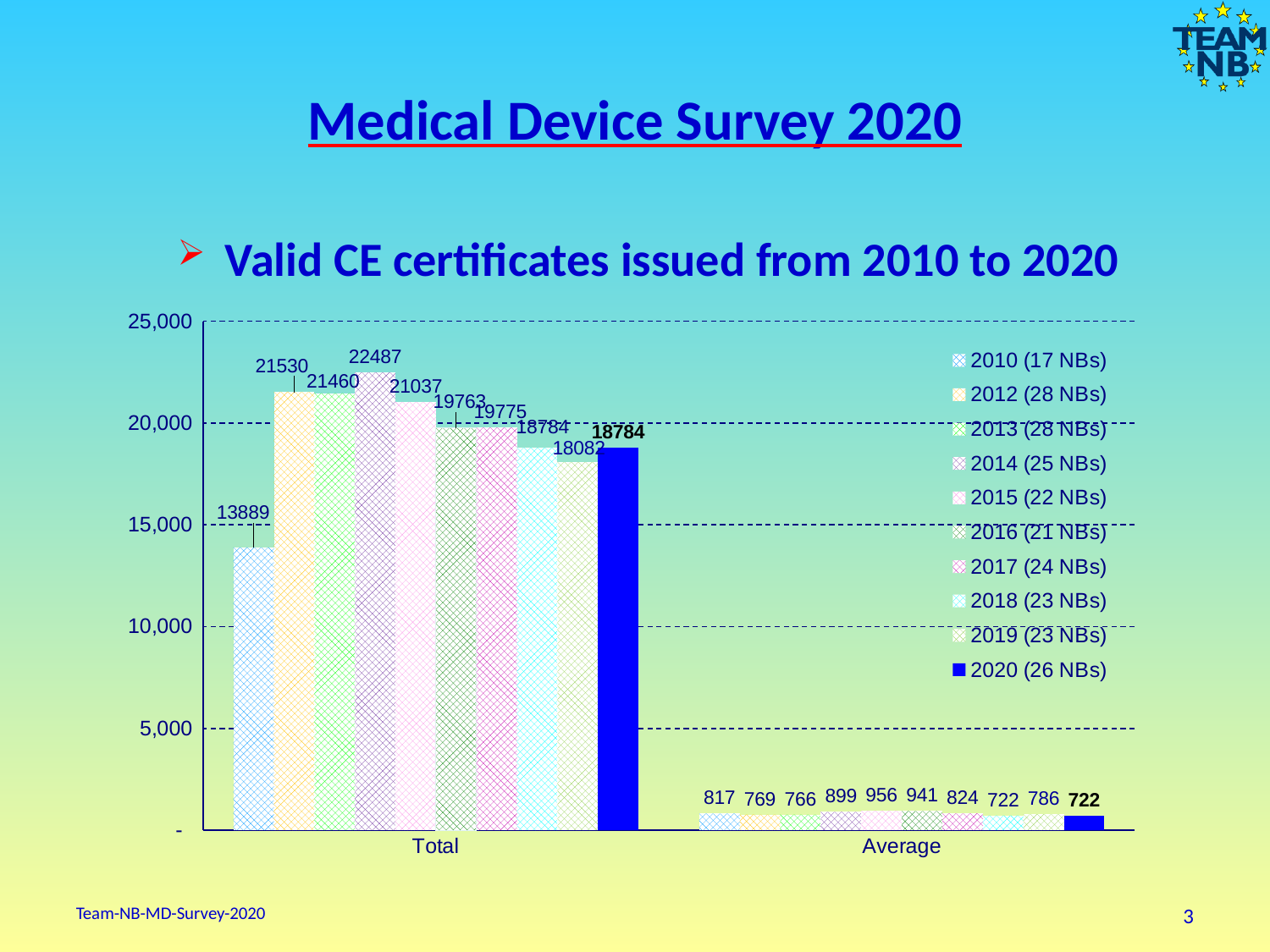
Is the Total value for 2010 (17 NBs) greater or less than 15,000? less What is the Total value for 2010 (17 NBs)? 13889 What is the Average value for 2015 (22 NBs)? 956 What kind of chart is shown on the slide? bar chart Which series has the highest Total value? 2014 (25 NBs) What is the difference between the Total values for 2014 (25 NBs) and 2010 (17 NBs)? 8598 Which series has the highest Average value? 2015 (22 NBs) What is the Total value for 2020 (26 NBs)? 18784 Which is larger, the Total value for 2012 (28 NBs) or for 2013 (28 NBs)? 2012 (28 NBs) How many categories are shown on the x axis? 2 How many series does the legend list? 10 Which series has the lowest Total value? 2010 (17 NBs)